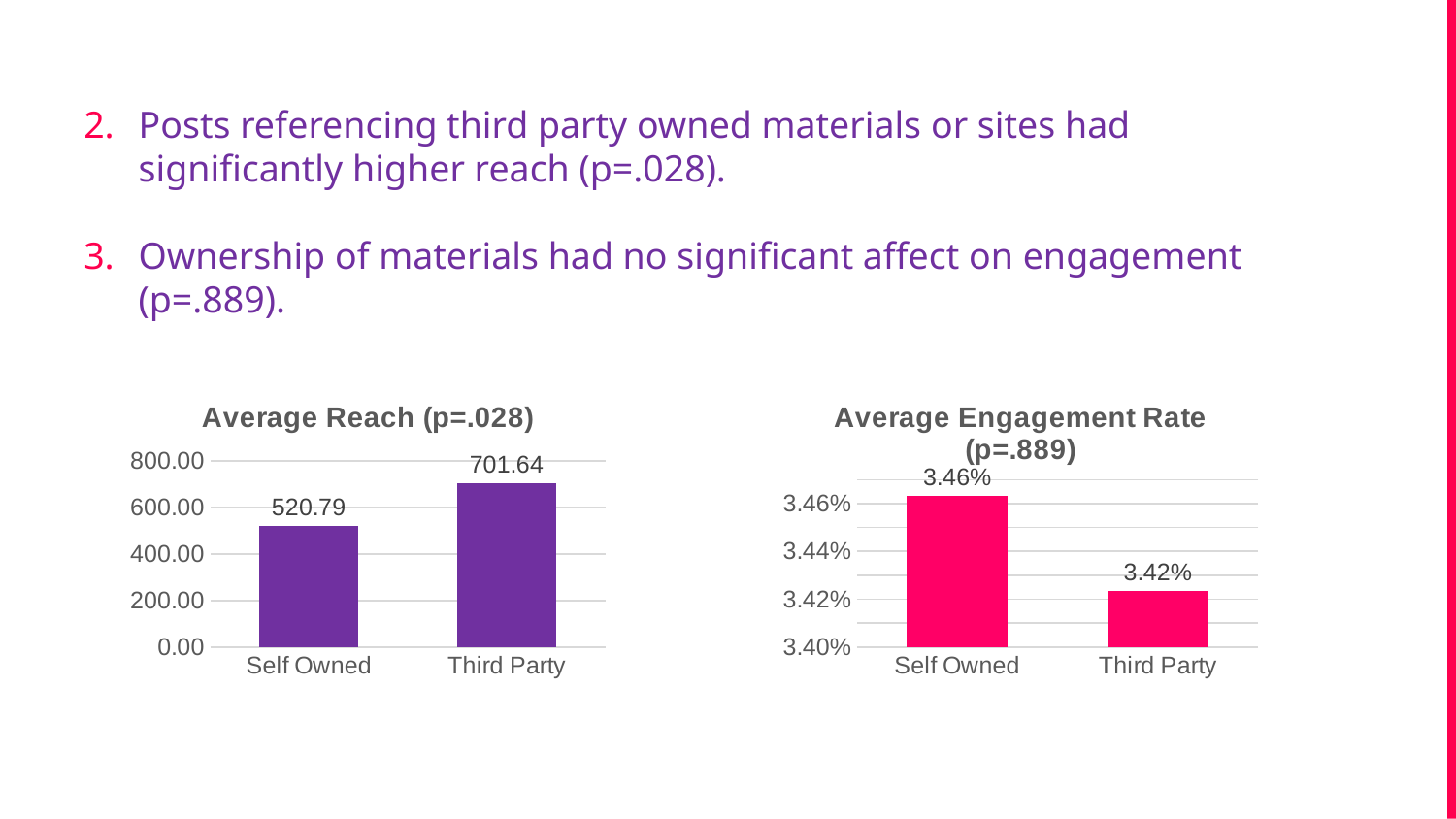
In the Average Engagement Rate (p=.889) chart, what is the value for Third Party? 3.42% How many categories are shown in the Average Reach (p=.028) chart? 2 In the Average Engagement Rate (p=.889) chart, which is larger, Self Owned or Third Party? Self Owned What colour are the bars in the Average Engagement Rate (p=.889) chart? pink In the Average Engagement Rate (p=.889) chart, what is the value for Self Owned? 3.46% In the Average Engagement Rate (p=.889) chart, which category has the lowest value? Third Party In the Average Reach (p=.028) chart, is the value for Self Owned greater or less than 600.00? less In the Average Reach (p=.028) chart, what is the value for Third Party? 701.64 In the Average Reach (p=.028) chart, what is the value for Self Owned? 520.79 What kind of chart is the Average Engagement Rate (p=.889) chart? bar chart In the Average Reach (p=.028) chart, what is the difference between Third Party and Self Owned? 180.85 In the Average Reach (p=.028) chart, which category has the highest value? Third Party